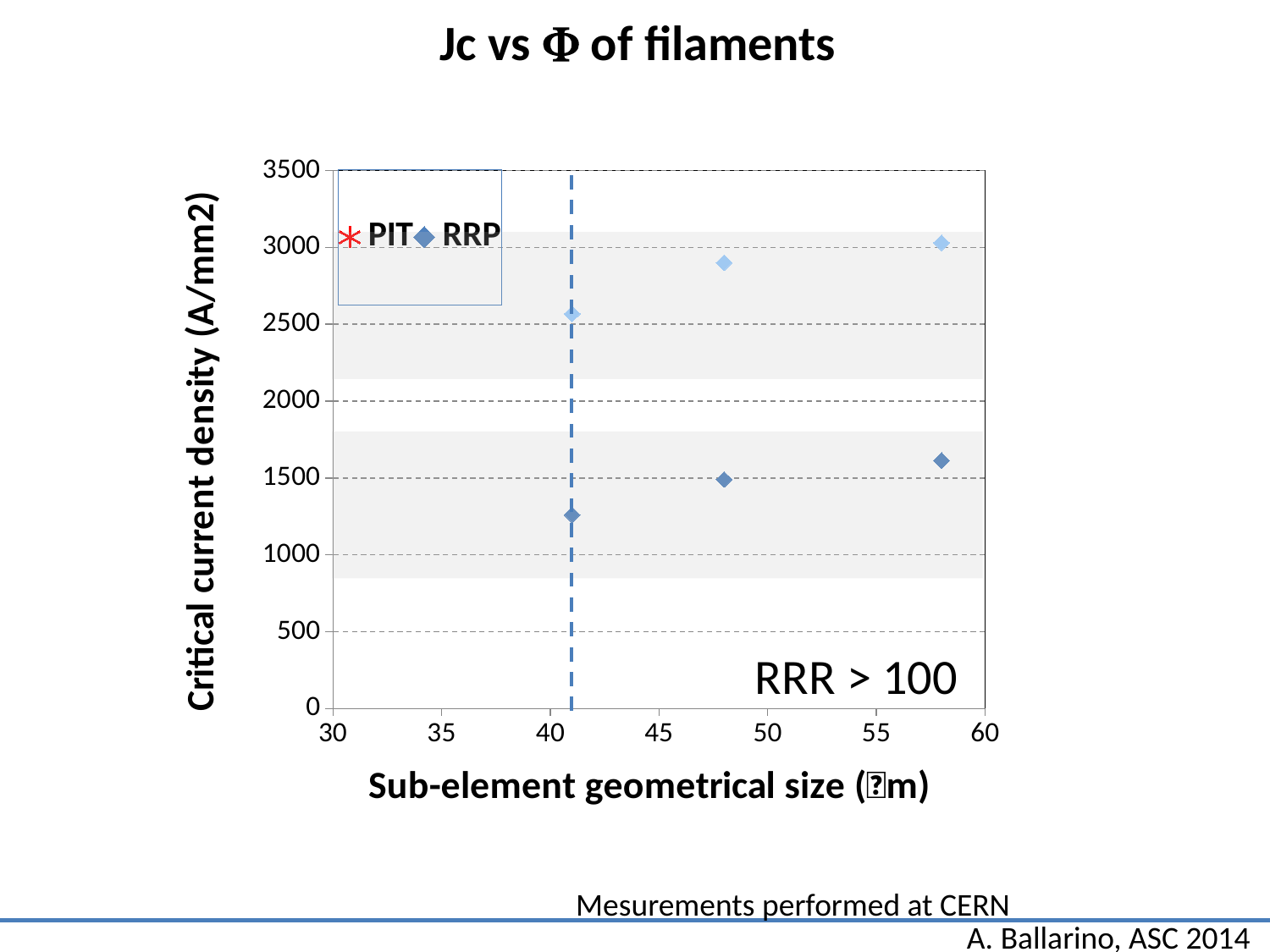
What is the title of the chart? Jc vs Φ of filaments How many data points are plotted for the RRP series (dark blue diamonds)? 3 How many series does the legend list? 2 Is the value of the light blue (upper) series at a sub-element size of 41 greater or less than 3000? less Is the RRP value at a sub-element size of 48 greater or less than 1000? greater Do the RRP values rise or fall as the sub-element geometrical size increases? rise Is the RRP value at a sub-element size of 41 greater or less than 1500? less What is the label of the y axis? Critical current density (A/mm2) What kind of chart is shown on the slide? scatter chart At a sub-element size of 48, which series has the higher critical current density: the light blue (upper) series or the RRP series? the light blue (upper) series